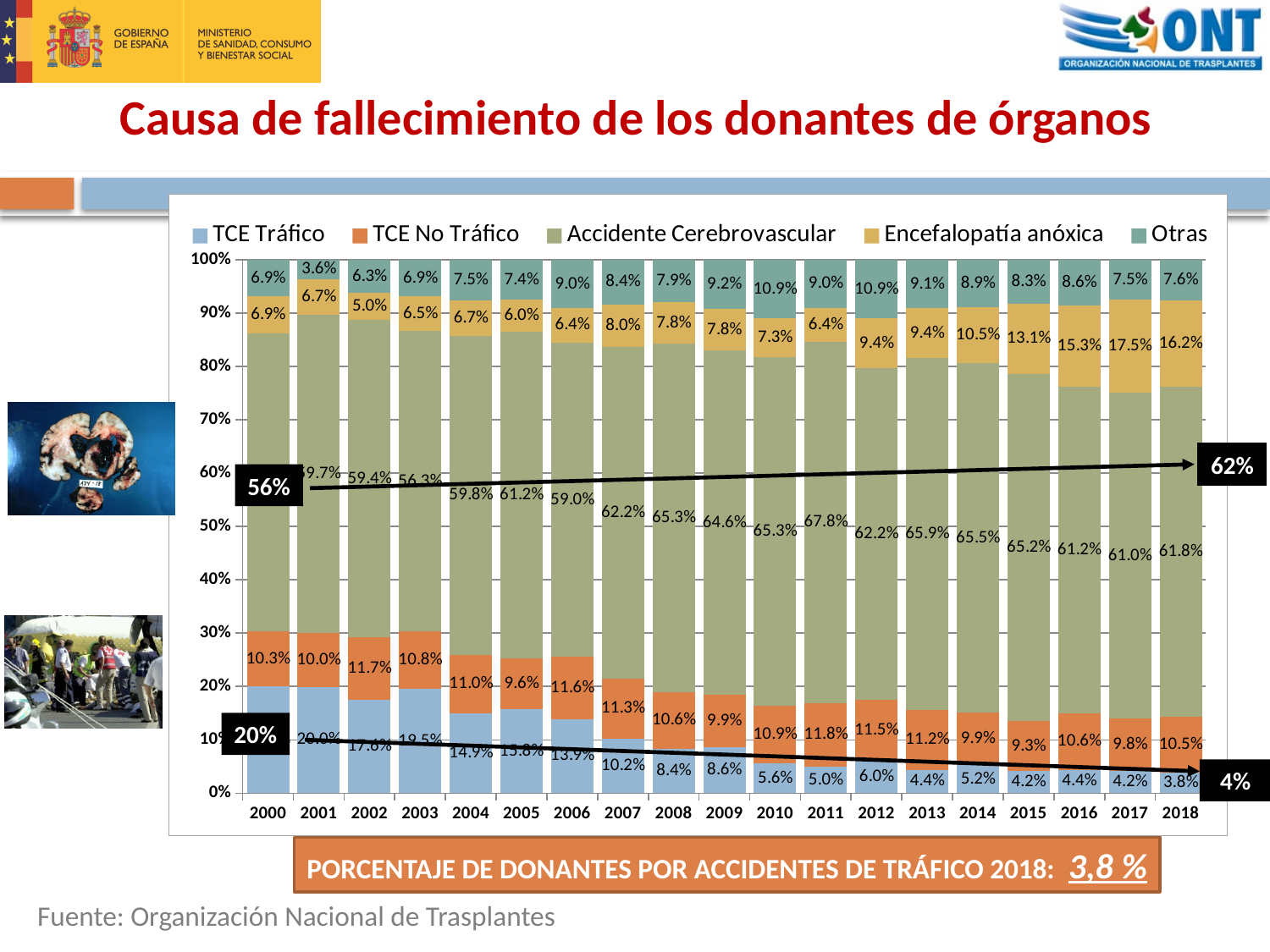
In which year is the TCE Tráfico value lowest? 2018 Does the TCE Tráfico share rise or fall from 2001 to 2018? Fall What is the difference between the TCE Tráfico values for 2001 and 2018? 16.2% What is the title of the slide containing the chart? Causa de fallecimiento de los donantes de órganos What kind of chart is shown on the slide? Stacked bar chart How many series does the legend list? 5 What is the value for Encefalopatía anóxica in 2016? 15.3% Which is larger, the Otras value in 2010 or in 2018? 2010 How many years are shown along the x axis? 19 What is the value for Accidente Cerebrovascular in 2011? 67.8% What is the value for TCE Tráfico in 2018? 3.8% In which year is the Encefalopatía anóxica value highest? 2017